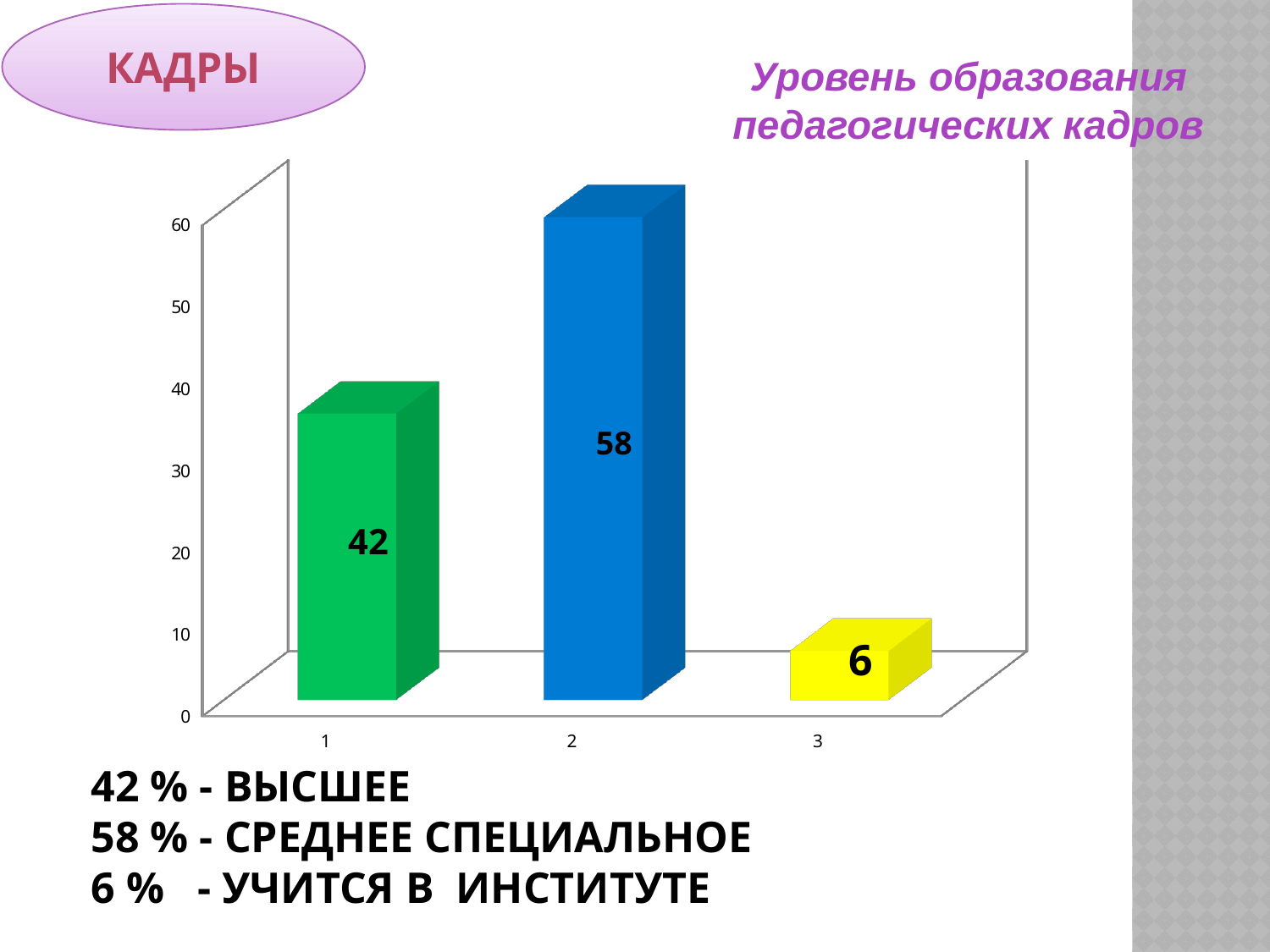
Which category has the lowest bar? 3 What is the value of the bar for category 2? 58 What is the title of the chart? Уровень образования педагогических кадров How many bars are shown in the chart? 3 What is the difference between the values for category 2 and category 1? 16 Which is larger, the value for category 1 or the value for category 3? category 1 Which category has the highest bar? 2 What is the value of the bar for category 1? 42 What is the value of the bar for category 3? 6 What colour is the bar for category 3? yellow Is the value for category 2 greater or less than 50? greater What kind of chart is shown on the slide? bar chart